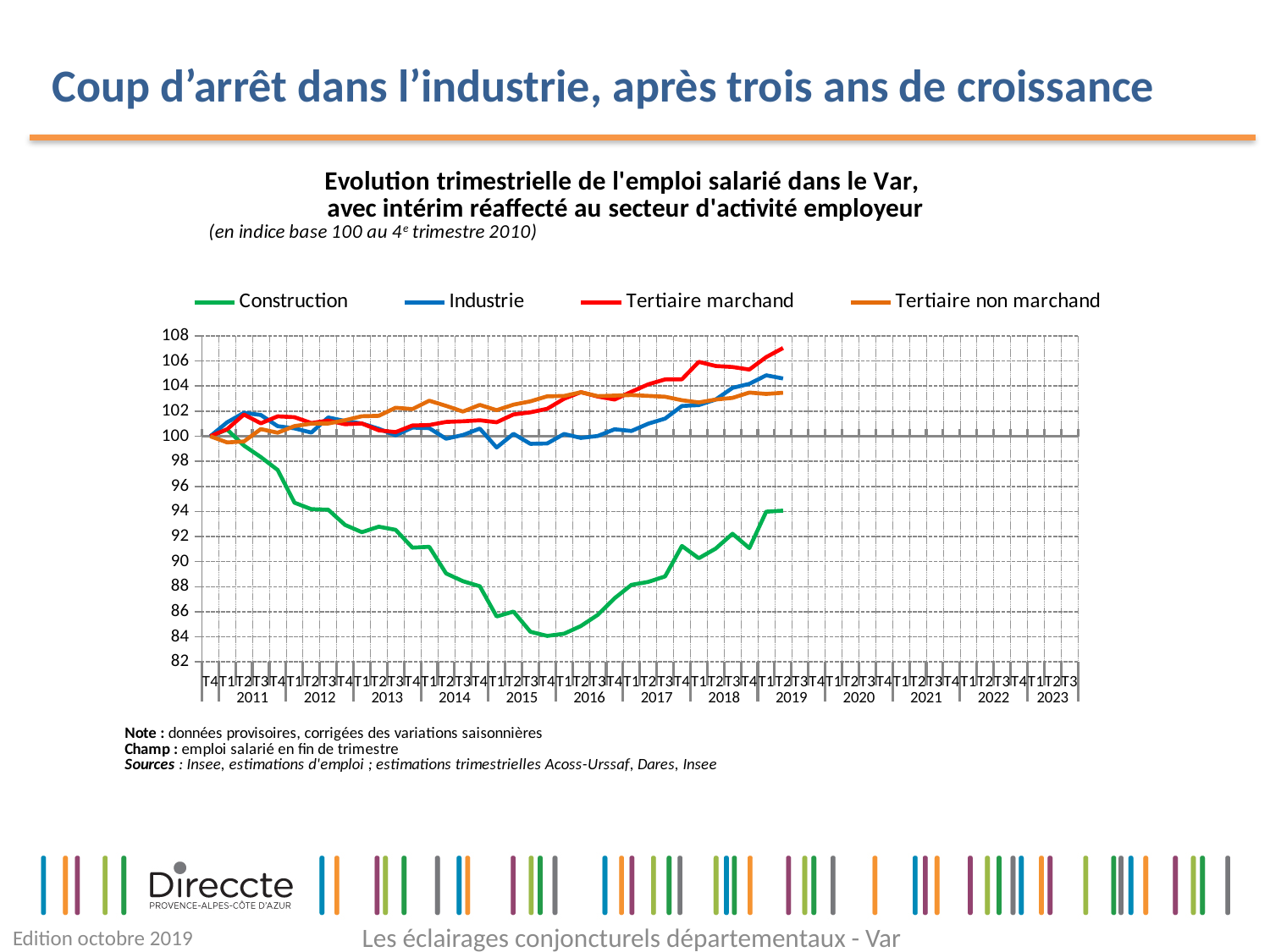
Is the value for Tertiaire marchand at the end of the plotted period greater or less than 106? greater Is the value for Tertiaire non marchand at the end of the plotted period greater or less than 104? less How many series does the legend list? 4 Which series is plotted in green? Construction Which series has the highest value at the end of the plotted period (2019)? Tertiaire marchand Does the Construction series rise or fall between 2011 and 2015? fall What kind of chart is shown on the slide? line chart Is the lowest value reached by Construction (around 2015) greater or less than 86? less At the end of the plotted period, which is larger: Industrie or Construction? Industrie What is the base period of the index used in the chart? 4e trimestre 2010 Which series has the lowest value at the end of the plotted period (2019)? Construction